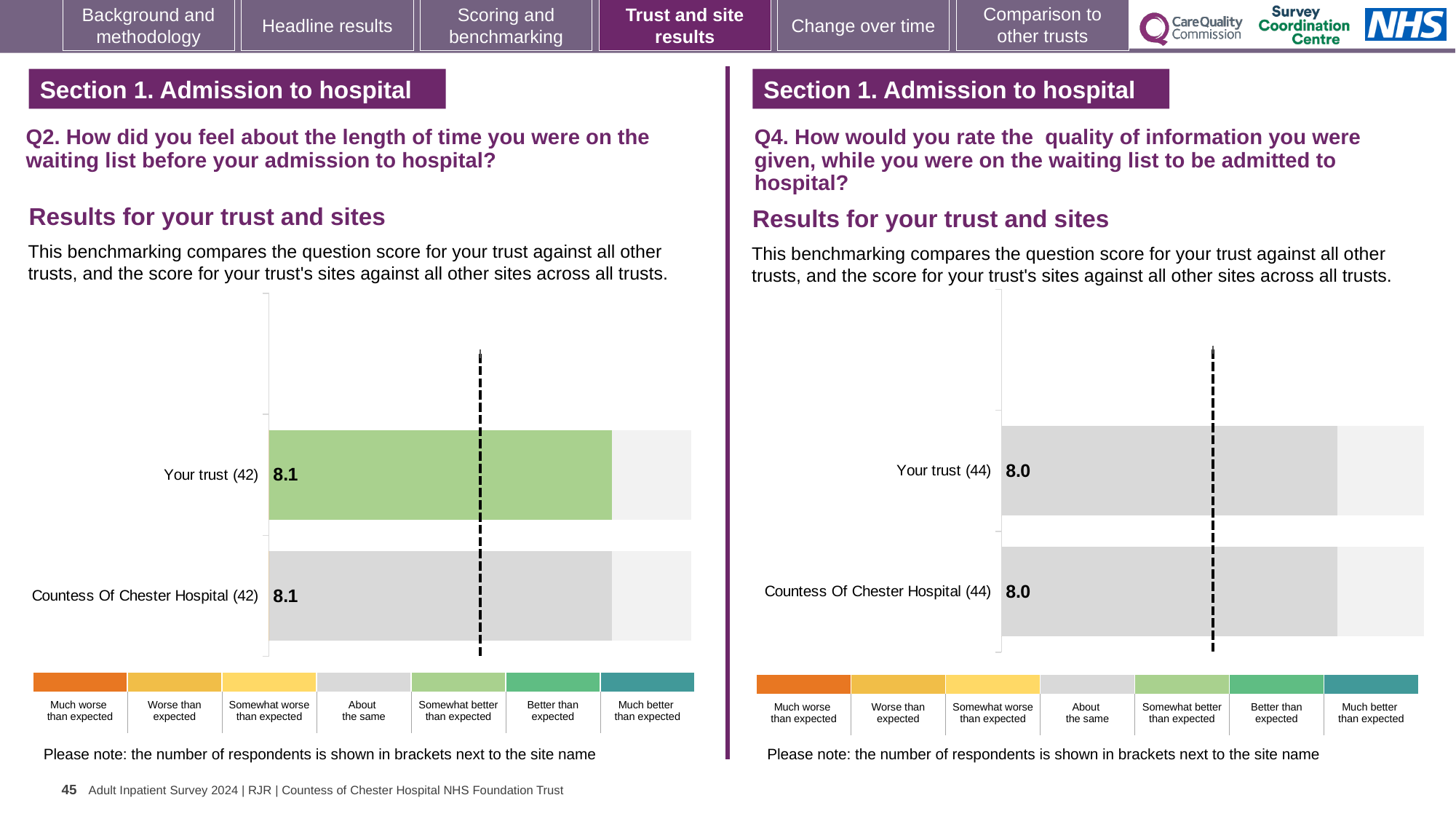
On the Q2 chart (left), how many respondents are shown in brackets for Your trust? 42 On the Q2 chart (left), what is the score for Countess Of Chester Hospital? 8.1 On the Q4 chart (right), how many respondents are shown in brackets for Countess Of Chester Hospital? 44 What kind of chart is the Q2 chart (left)? Bar chart On the Q4 chart (right), what is the score for Your trust? 8.0 On the Q2 chart (left), what is the score for Your trust? 8.1 On the Q4 chart (right), what is the difference between the score for Your trust and the score for Countess Of Chester Hospital? 0.0 On the Q4 chart (right), what is the score for Countess Of Chester Hospital? 8.0 Is the score for Your trust on the Q4 chart (right) greater or less than the score for Your trust on the Q2 chart (left)? less How many bars are plotted on the Q4 chart (right)? 2 On the Q2 chart (left), what is the difference between the score for Your trust and the score for Countess Of Chester Hospital? 0.0 How many bars are plotted on the Q2 chart (left)? 2